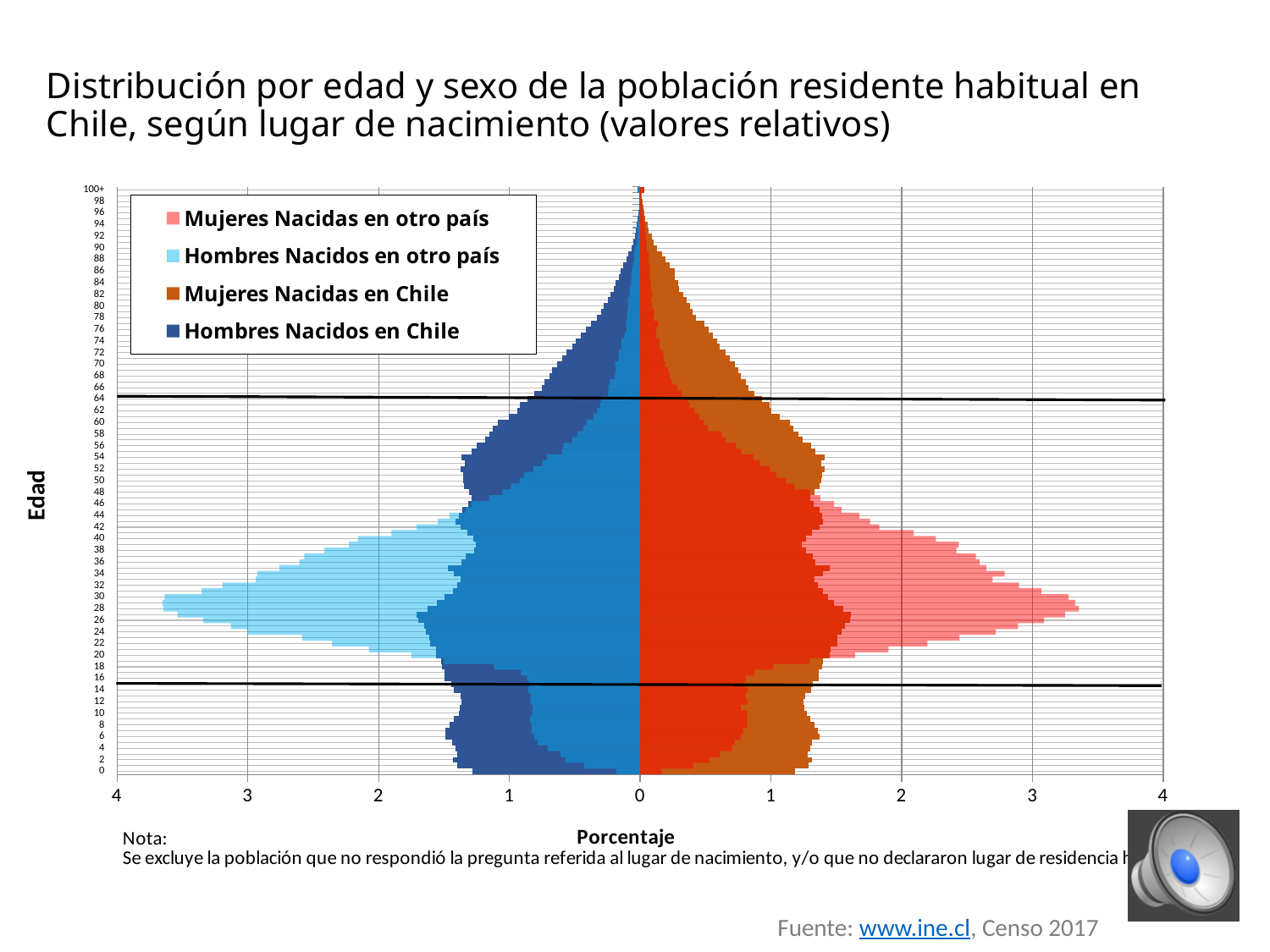
Is the value for Hombres Nacidos en otro país at age 40 greater or less than 1? greater What kind of chart is shown on the slide? bar chart Which series is shown in light blue according to the legend? Hombres Nacidos en otro país Is the value for Hombres Nacidos en Chile at age 80 greater or less than 1? less Is the value for Mujeres Nacidas en Chile at age 80 greater or less than 1? less How many series does the legend list? 4 For ages above 70, do the bars for Hombres Nacidos en Chile get longer or shorter as age increases? shorter Which is larger at age 28: the value for Hombres Nacidos en otro país or the value for Hombres Nacidos en Chile? Hombres Nacidos en otro país What is the label of the horizontal axis? Porcentaje